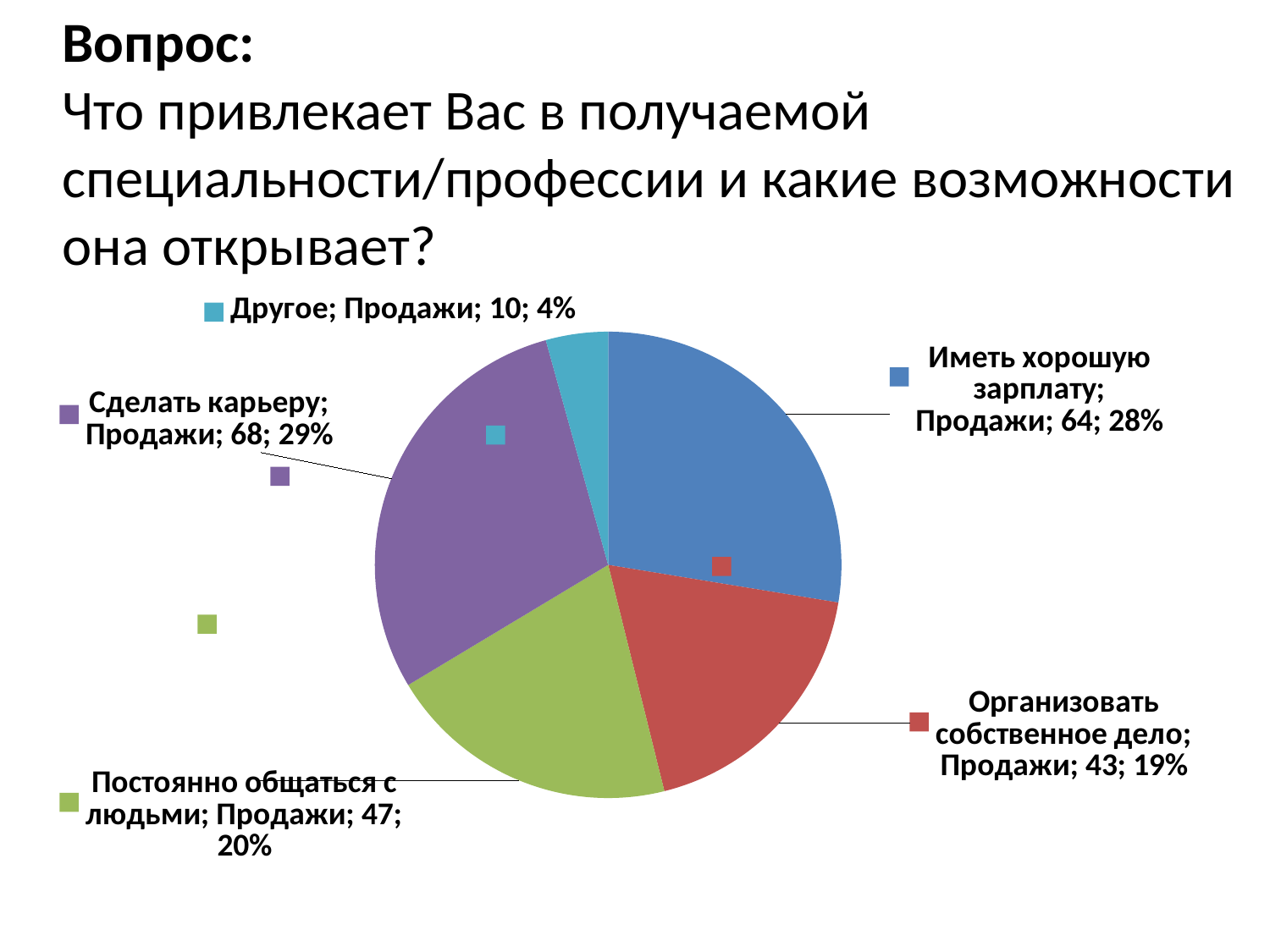
Which category has the smallest slice? Другое What share of the pie does "Сделать карьеру" represent? 29% What kind of chart is shown on the slide? pie chart Which category has the largest slice? Сделать карьеру What share of the pie does "Другое" represent? 4% How many slices does the pie chart have? 5 What is the value for "Постоянно общаться с людьми"? 47 What is the difference between the values for "Сделать карьеру" and "Иметь хорошую зарплату"? 4 What is the value for "Организовать собственное дело"? 43 Which is larger, the value for "Постоянно общаться с людьми" or "Организовать собственное дело"? Постоянно общаться с людьми What is the value for "Другое"? 10 What is the value for "Иметь хорошую зарплату"? 64